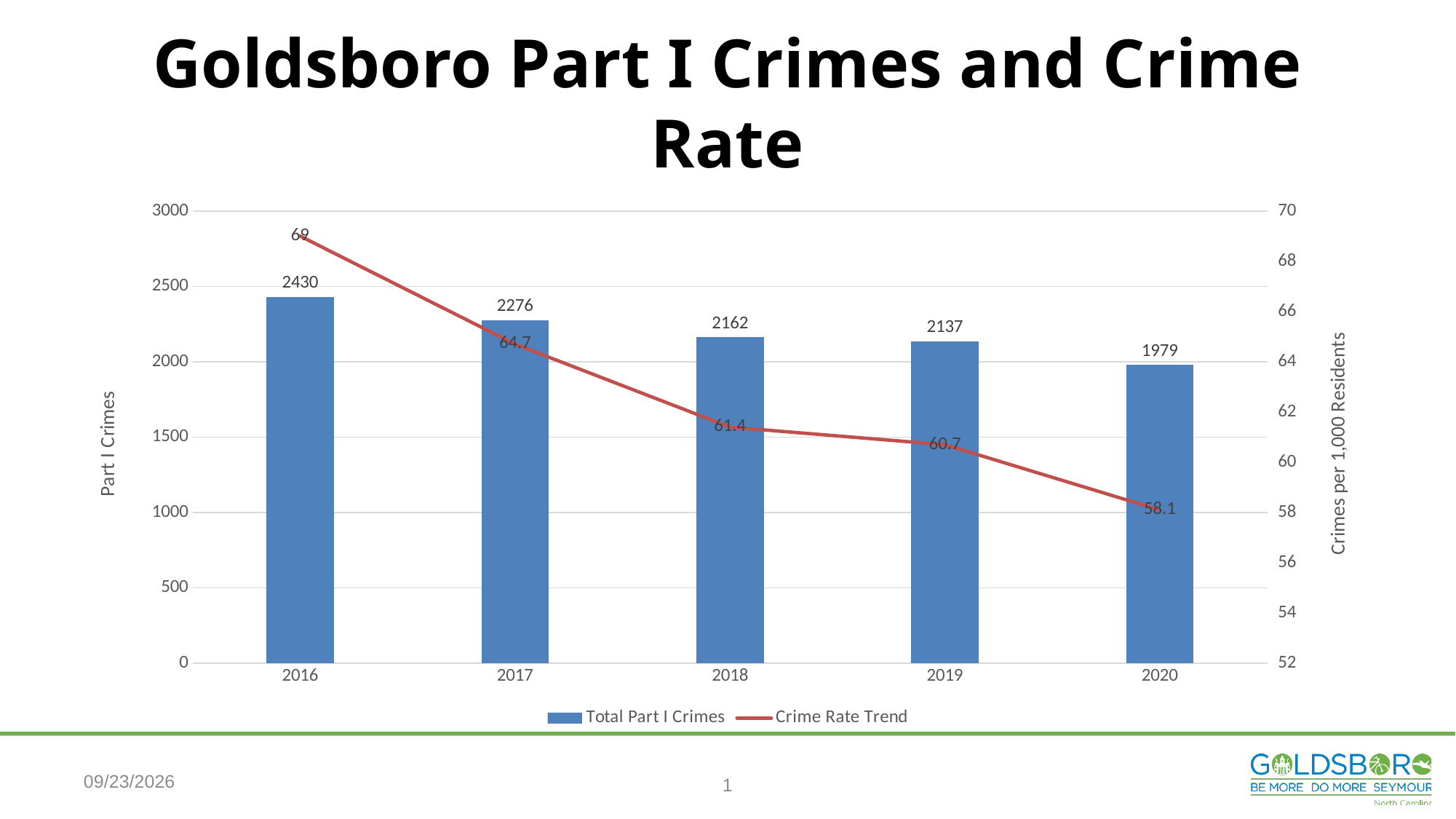
Which year had more Total Part I Crimes, 2017 or 2019? 2017 What was the Total Part I Crimes value in 2016? 2430 What was the Total Part I Crimes value in 2020? 1979 Which year had the highest Total Part I Crimes? 2016 How many years are shown on the x axis? 5 What was the Crime Rate Trend value in 2016? 69 How many series does the legend list? 2 What is the label of the right-hand vertical axis? Crimes per 1,000 Residents Do the Total Part I Crimes values rise or fall from 2016 to 2020? fall What was the Crime Rate Trend value in 2018? 61.4 What is the difference in Total Part I Crimes between 2016 and 2020? 451 Which year had the lowest Crime Rate Trend value? 2020